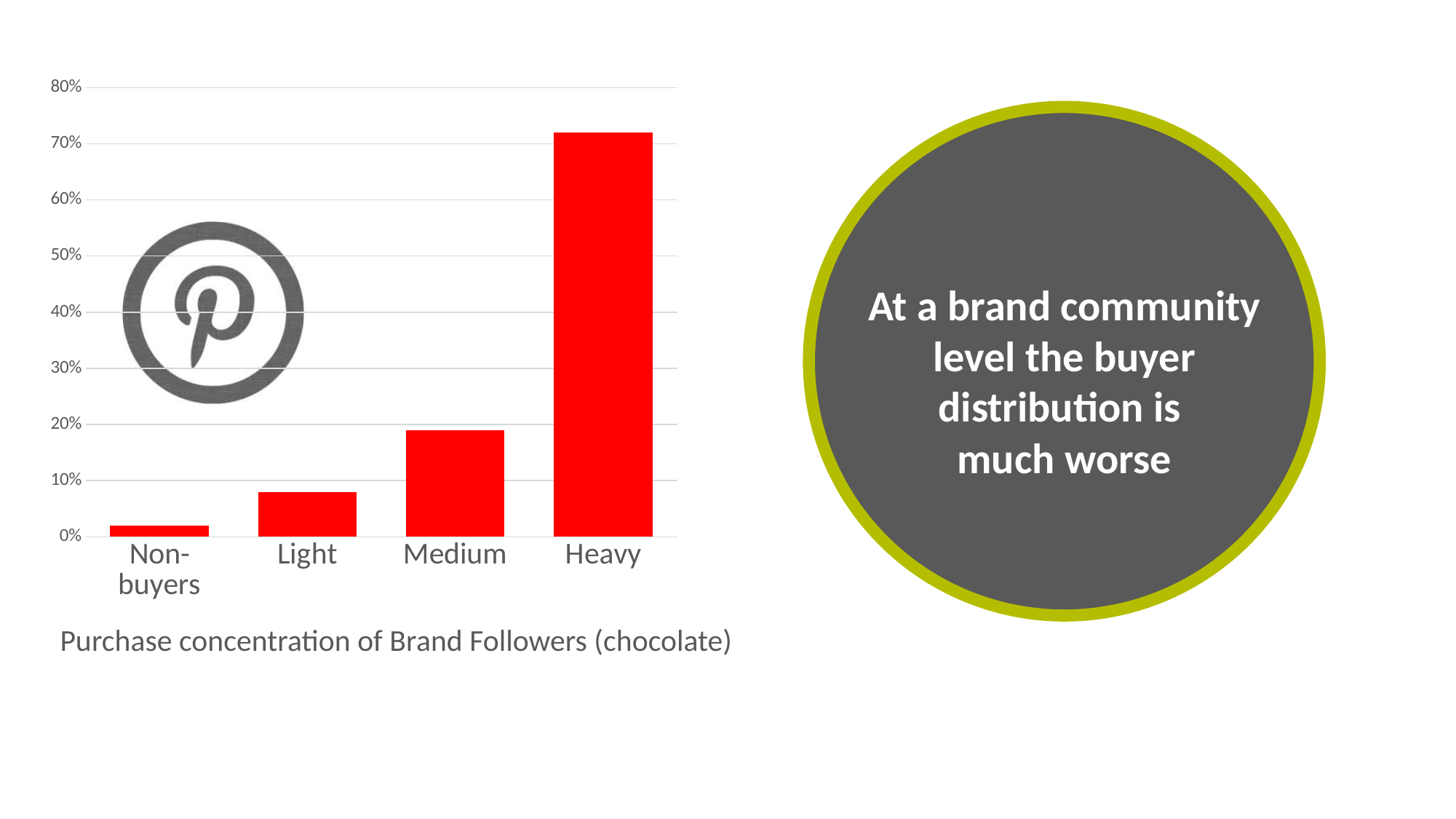
How many categories are shown on the x axis of the chart? 4 Which category has the highest value in the chart? Heavy Is the value for Non-buyers greater or less than 10%? less Which category has the lowest value in the chart? Non-buyers What colour are the bars in the chart? red What is the title of the chart? Purchase concentration of Brand Followers (chocolate) Is the value for Heavy greater or less than 60%? greater Is the value for Light greater or less than 10%? less What kind of chart is shown on the slide? bar chart Do the values rise or fall moving from Non-buyers to Heavy along the x axis? rise Which is larger, the value for Medium or the value for Light? Medium